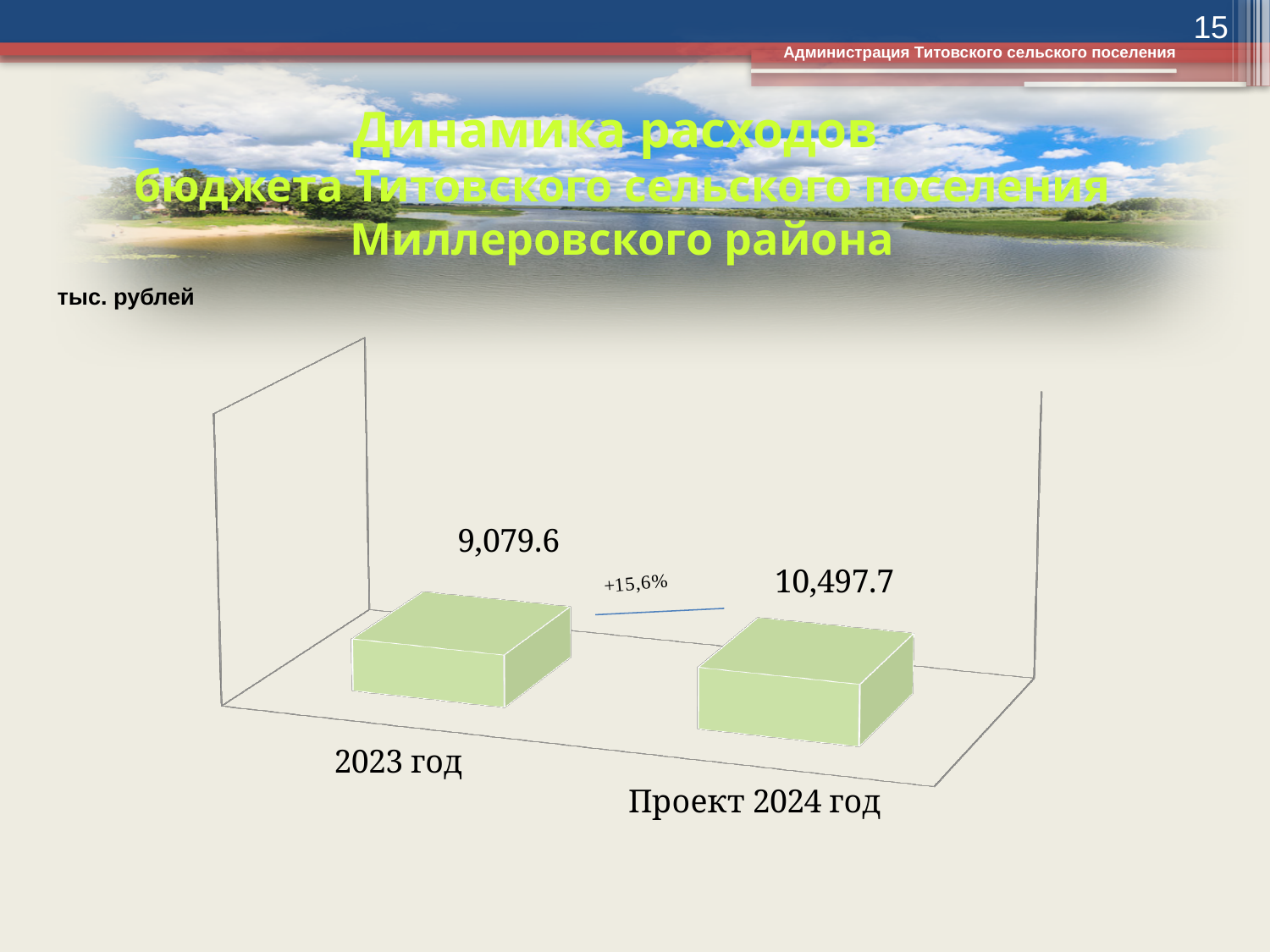
What is the difference between the values for Проект 2024 год and 2023 год? 1,418.1 What unit of measurement is indicated for the chart values? тыс. рублей What kind of chart is shown on the slide? Bar chart Do the values rise or fall from 2023 год to Проект 2024 год? Rise What is the value shown for Проект 2024 год? 10,497.7 Which category has the highest value? Проект 2024 год How many categories are plotted in the chart? 2 Which is larger, the value for 2023 год or the value for Проект 2024 год? Проект 2024 год Which category has the lowest value? 2023 год What is the value shown for 2023 год? 9,079.6 What percentage change is annotated between the two bars? +15,6%